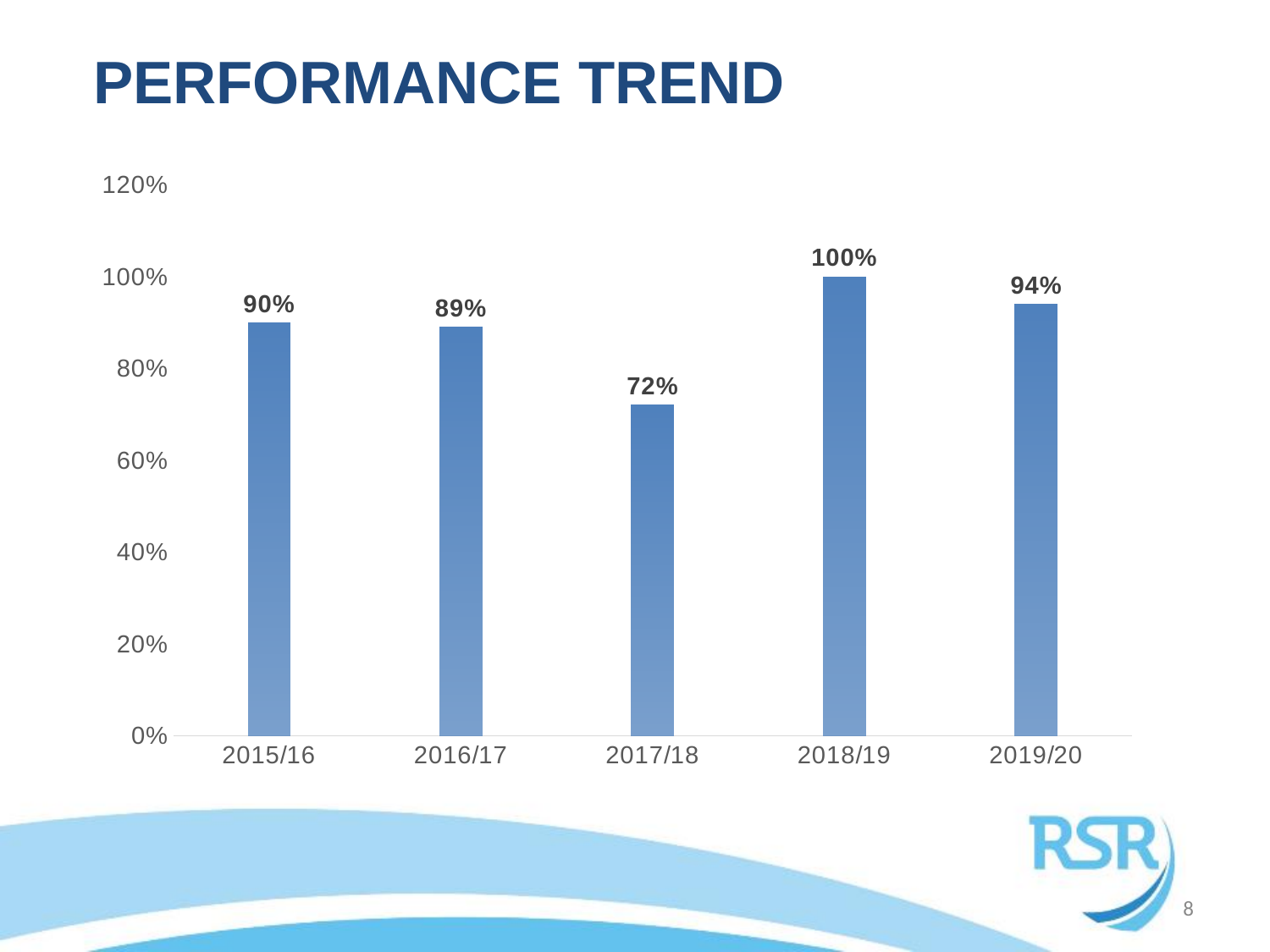
Which year has the highest value? 2018/19 Which is larger, the value for 2015/16 or the value for 2019/20? 2019/20 What is the title of the slide? PERFORMANCE TREND What is the difference between the values for 2019/20 and 2016/17? 5% What is the value for 2015/16? 90% Is the value for 2017/18 greater or less than 80%? less What kind of chart is shown on the slide? bar chart How many years are shown on the x axis? 5 What is the difference between the values for 2018/19 and 2017/18? 28% What is the value for 2019/20? 94% Which year has the lowest value? 2017/18 What is the value for 2017/18? 72%